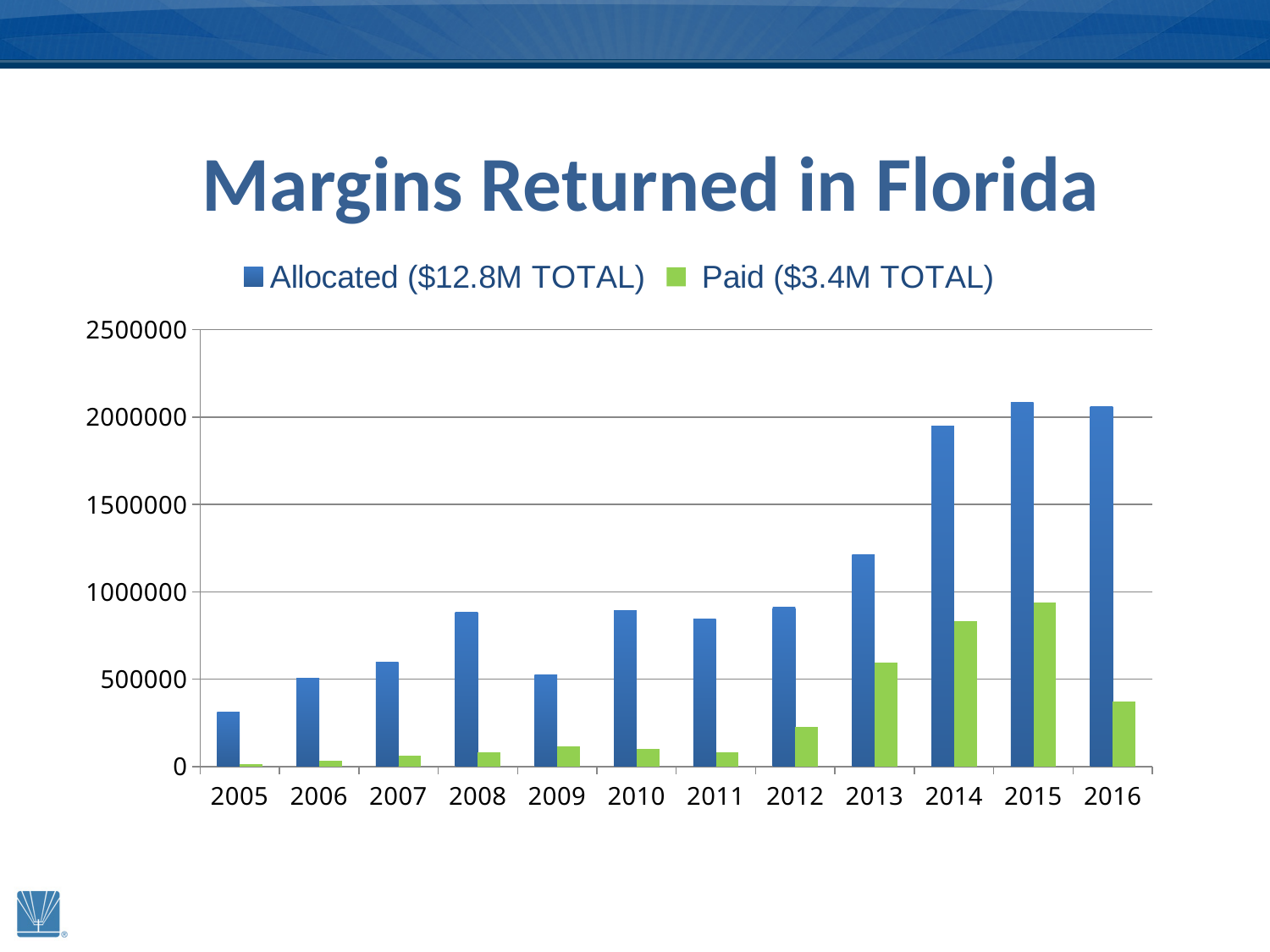
Which year has the highest Paid value? 2015 What is the title of the chart? Margins Returned in Florida Which year has the lowest Paid value? 2005 Is the Allocated value for 2013 greater or less than 1000000? greater How many series does the chart's legend list? 2 What kind of chart is shown on the slide? bar chart Is the Paid value for 2016 greater or less than 500000? less Which is larger, the Paid value for 2014 or the Paid value for 2016? 2014 What total is given in the legend for the Paid series? $3.4M TOTAL Which is larger, the Allocated value for 2008 or the Allocated value for 2009? 2008 Which year has the lowest Allocated value? 2005 How many years are shown on the x axis of the chart? 12